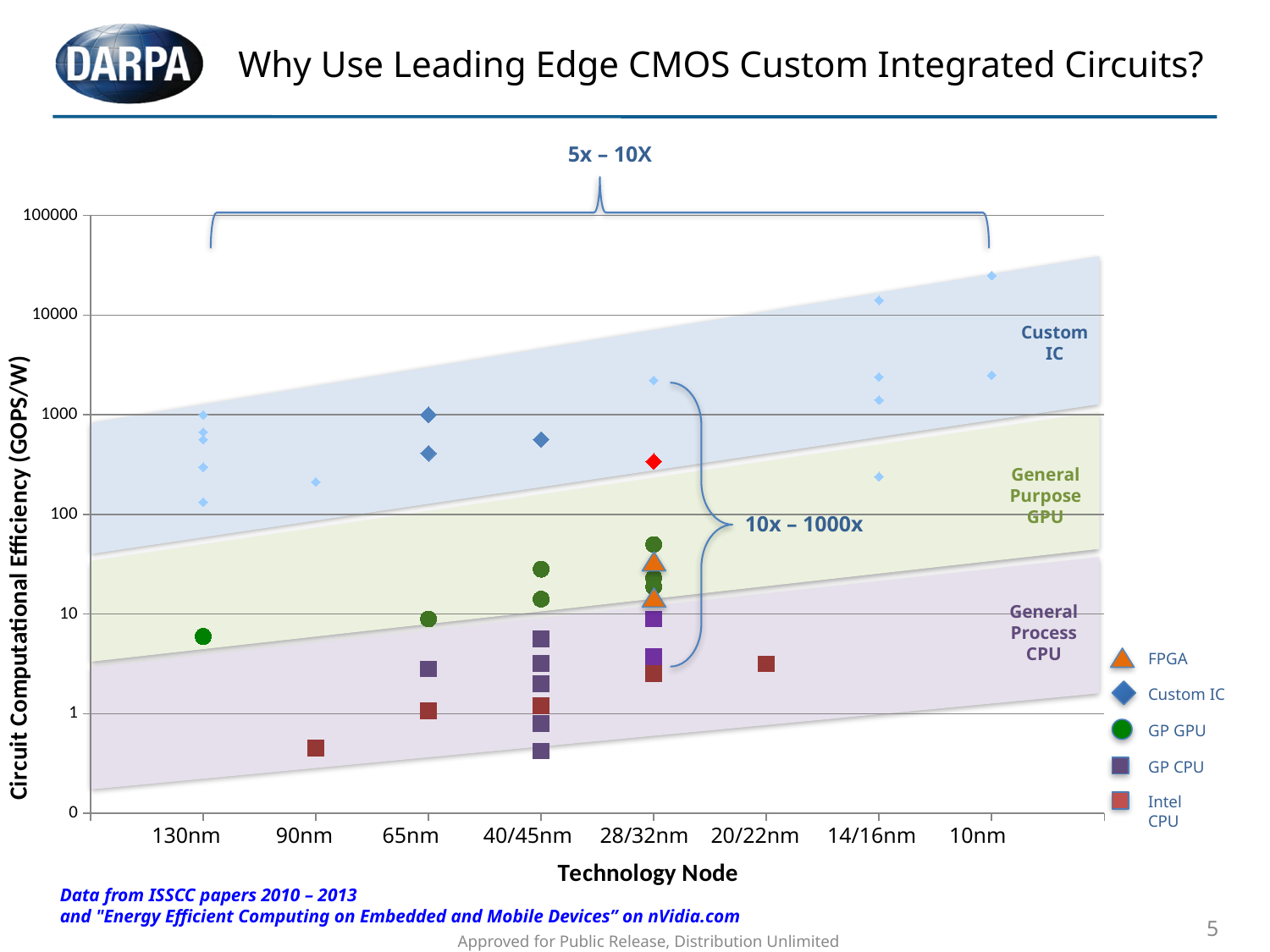
What is the title of the x axis? Technology Node Is the highest Custom IC value at 10nm greater or less than 10000? greater Which is larger: the GP GPU value at 130nm or the highest GP GPU value at 28/32nm? 28/32nm Do the highest Custom IC values rise or fall moving from 130nm to 10nm along the x axis? rise Is the GP GPU value at 130nm greater or less than 10? less At which technology node does the Custom IC series reach its highest value? 10nm What kind of chart is shown on the slide? Scatter chart Is the Intel CPU value at 90nm greater or less than 1? less How many series does the legend list? 5 What is the title of the y axis? Circuit Computational Efficiency (GOPS/W) How many technology nodes are labelled along the x axis? 8